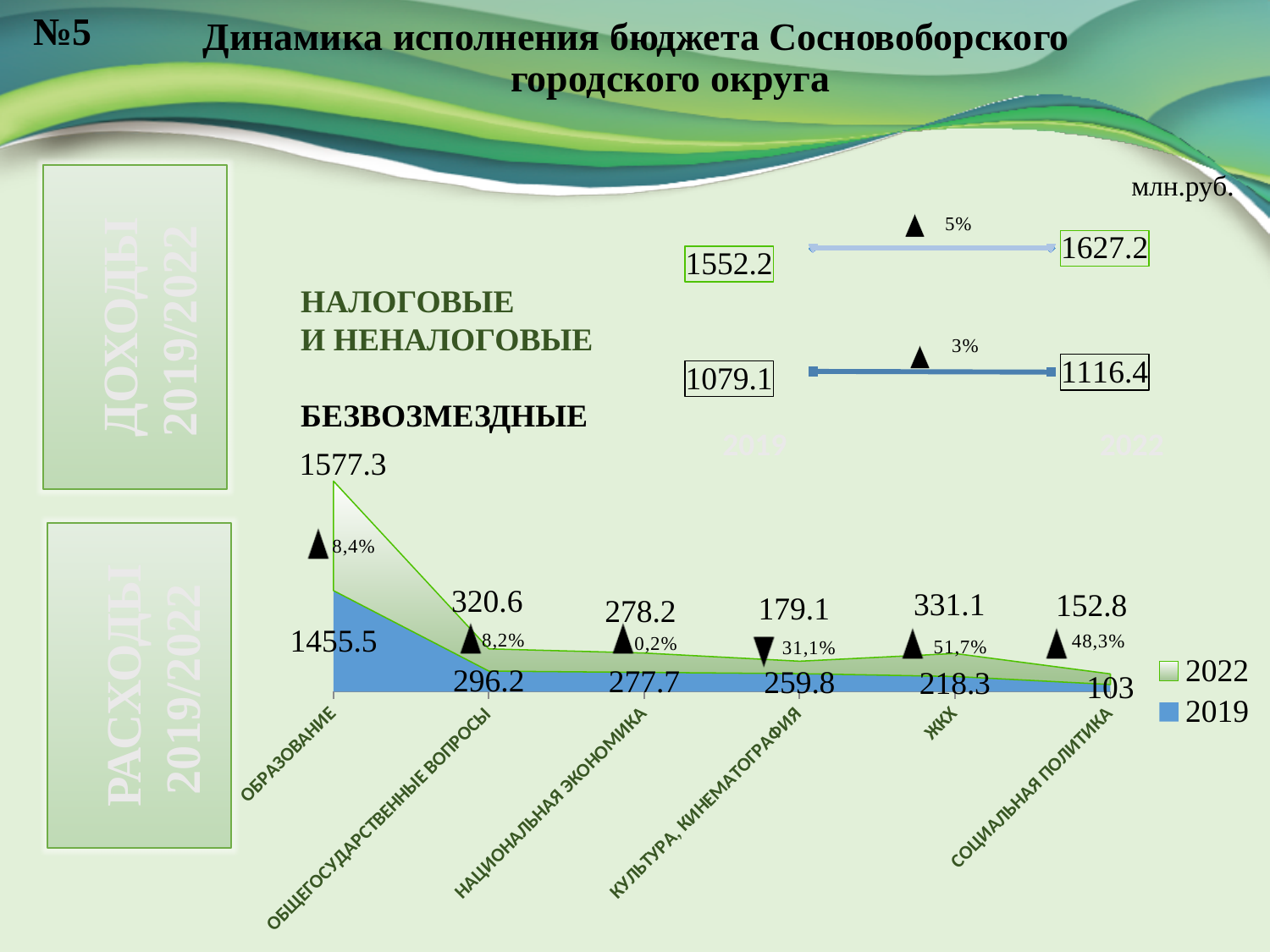
How many series does the legend of the bottom area chart list? 2 On the bottom area chart of expenses, which category has the lowest 2019 value? СОЦИАЛЬНАЯ ПОЛИТИКА On the bottom area chart of expenses, which category has the highest 2022 value? ОБРАЗОВАНИЕ On the bottom area chart of expenses, what is the 2019 value for СОЦИАЛЬНАЯ ПОЛИТИКА? 103 On the bottom area chart of expenses, what is the difference between the 2022 and 2019 values for ЖКХ? 112.8 How many categories are shown on the bottom area chart of expenses? 6 On the bottom area chart of expenses, what is the 2022 value for ОБРАЗОВАНИЕ? 1577.3 On the top-right line chart of income, what is the difference between the 2022 and 2019 values for БЕЗВОЗМЕЗДНЫЕ? 37.3 What kind of chart is the bottom chart of expenses? Area chart On the bottom area chart of expenses, which is larger for КУЛЬТУРА, КИНЕМАТОГРАФИЯ: the 2019 value or the 2022 value? 2019 On the top-right line chart of income, what is the 2022 value for НАЛОГОВЫЕ И НЕНАЛОГОВЫЕ? 1627.2 On the bottom area chart of expenses, what is the 2019 value for ЖКХ? 218.3